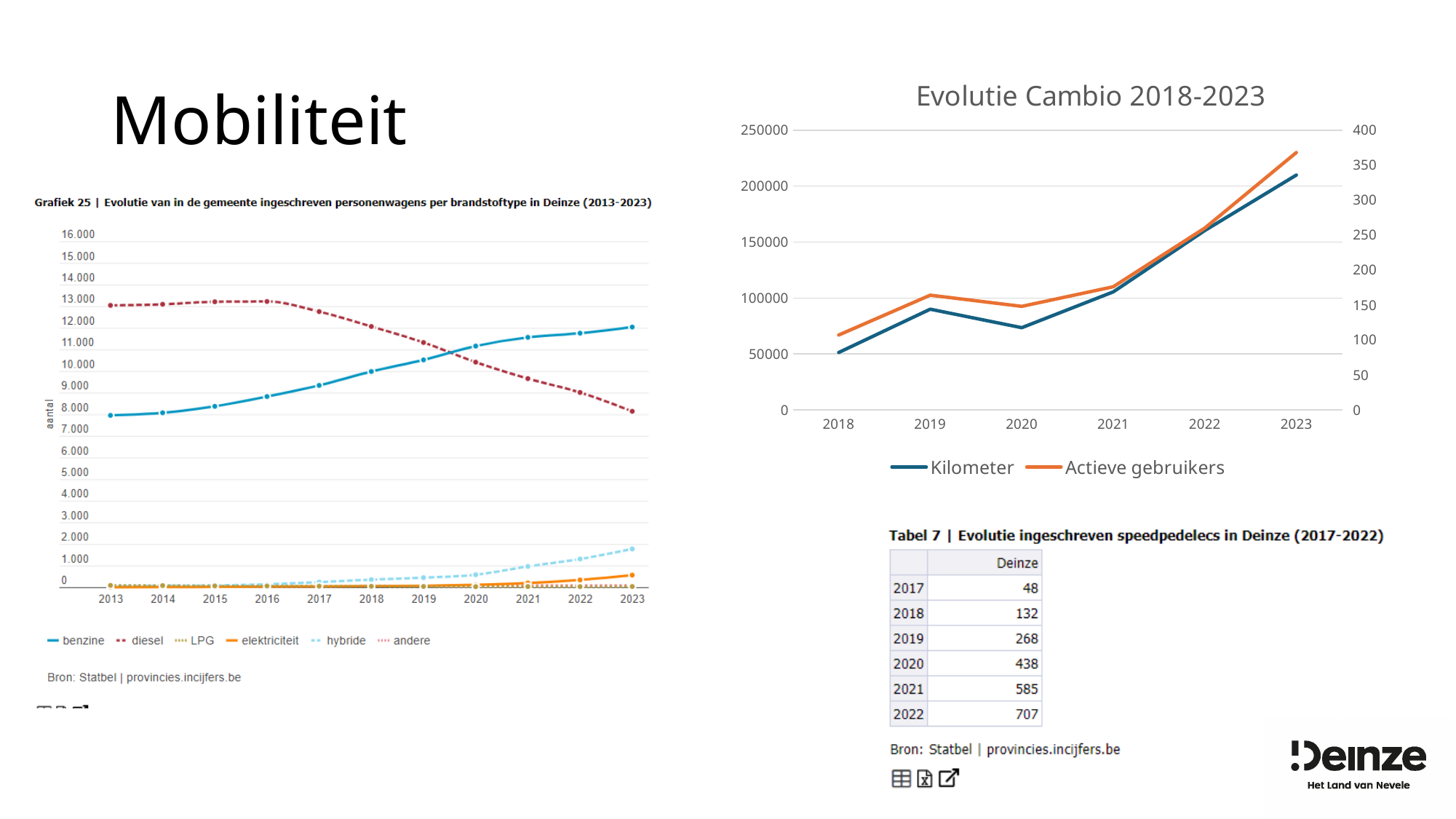
In Grafiek 25, does the diesel line rise or fall from 2016 to 2023? fall How many series does the legend of Grafiek 25 list? 6 In Grafiek 25, which fuel type has the highest value in 2013? diesel In Grafiek 25, is the value for benzine in 2023 greater or less than 11.000? greater How many years are shown on the x axis of Grafiek 25? 11 How many series does the legend of the 'Evolutie Cambio 2018-2023' chart list? 2 In Grafiek 25, which is larger in 2023, benzine or diesel? benzine In the 'Evolutie Cambio 2018-2023' chart, which year has the highest Kilometer value? 2023 What kind of chart is Grafiek 25 on the left of the slide? line chart In Grafiek 25, does the benzine line rise or fall from 2013 to 2023? rise How many years are plotted on the x axis of the 'Evolutie Cambio 2018-2023' chart? 6 In the 'Evolutie Cambio 2018-2023' chart, is the Kilometer value for 2018 greater or less than 100000? less